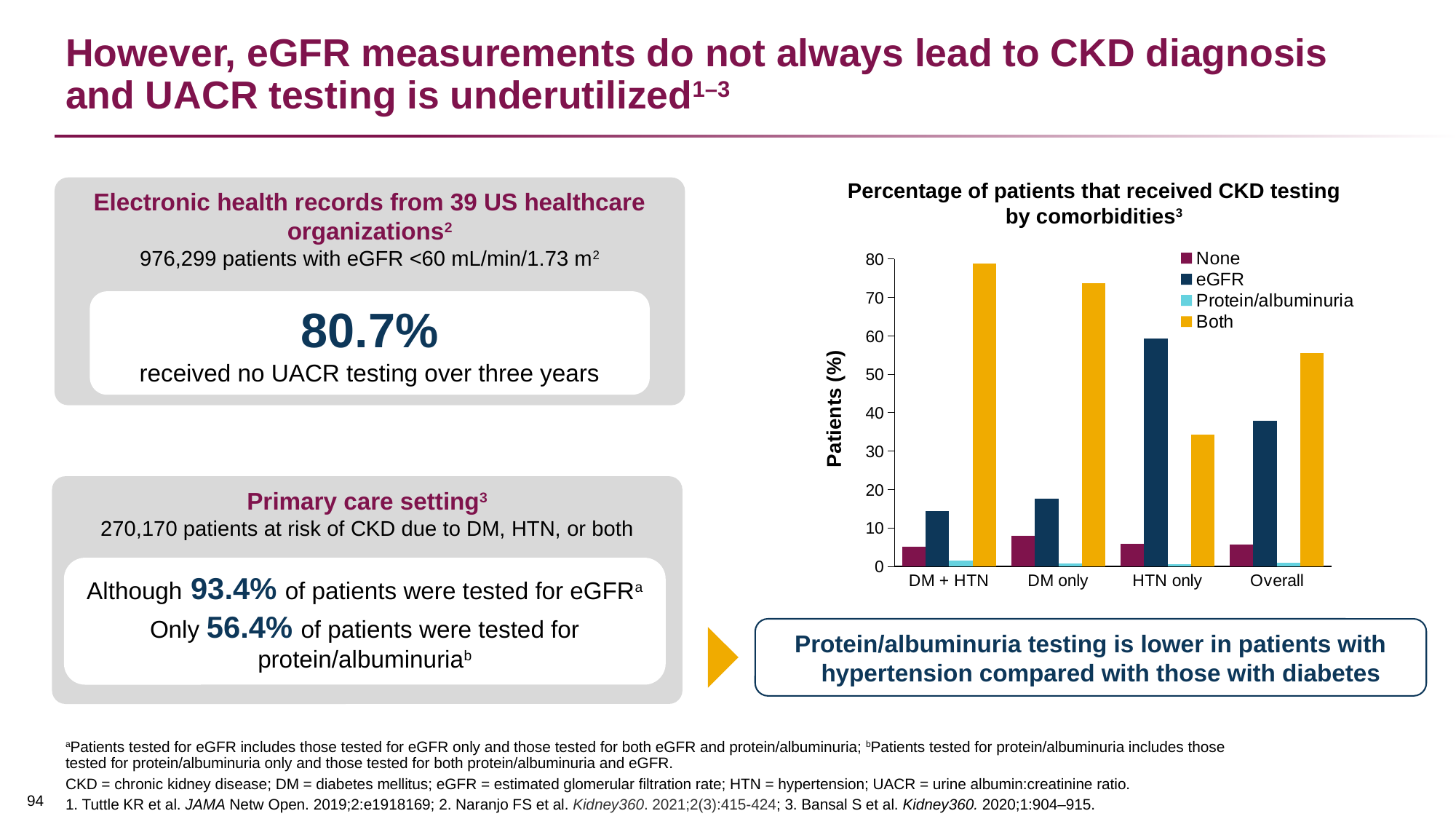
Is the value for eGFR in the HTN only category greater or less than 50? greater How many comorbidity categories are shown on the x axis of the chart? 4 In the Overall category, which is larger: the eGFR value or the Both value? Both Which category has the highest value for the Both series? DM + HTN Is the value for Both in the DM + HTN category greater or less than 70? greater What kind of chart is shown on the slide? Bar chart How many series does the legend of the chart list? 4 Is the value for Both in the HTN only category greater or less than 40? less Which category has the lowest value for the Both series? HTN only Which is larger: the None value for DM only or the None value for DM + HTN? DM only What is the title of the chart? Percentage of patients that received CKD testing by comorbidities Which category has the highest value for the eGFR series? HTN only